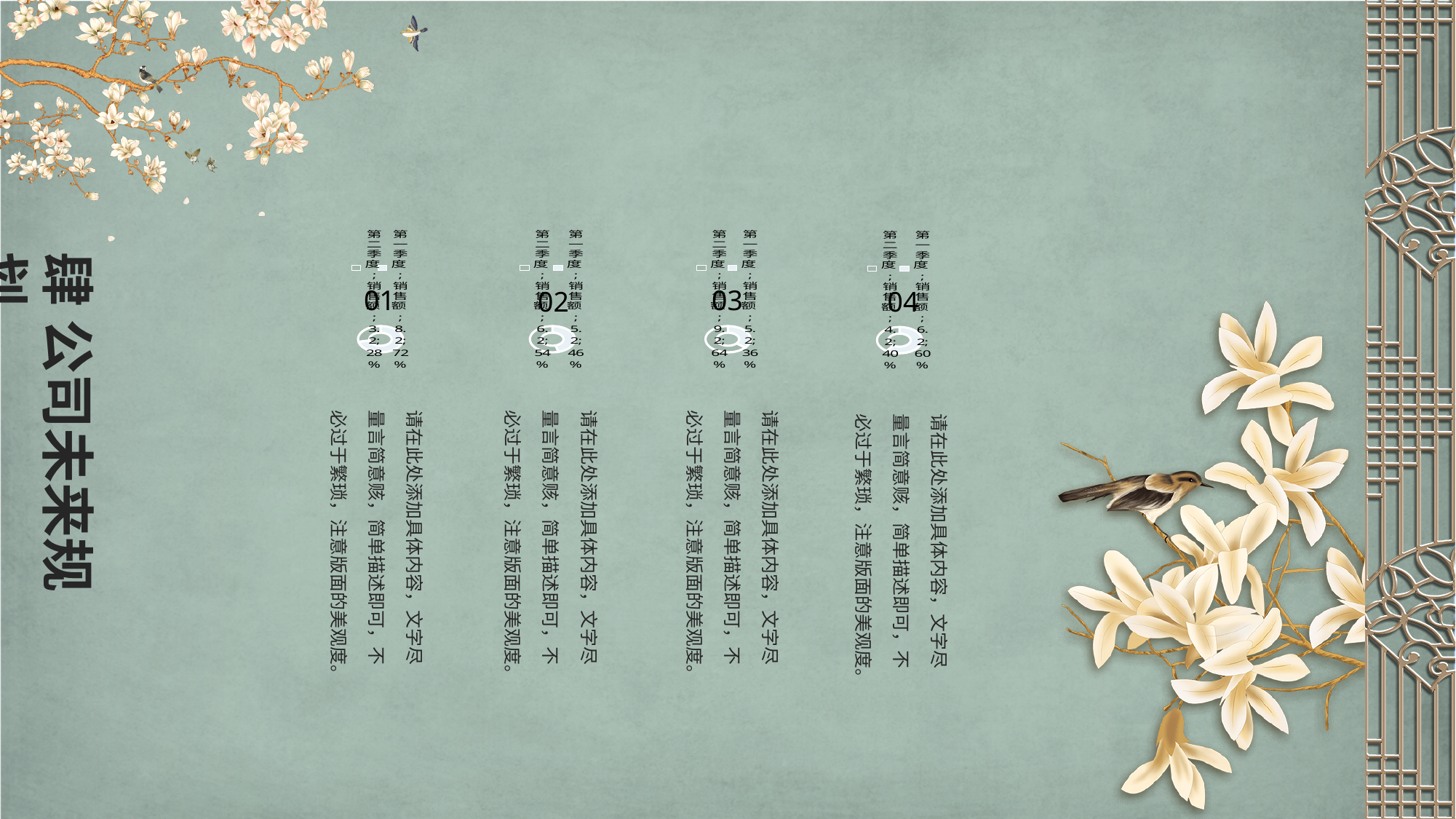
In the chart labelled 03, what is the 销售额 value shown for 第二季度? 9.2 In the chart labelled 01, what is the share shown for 第一季度? 72% What kind of chart is used for the four small charts labelled 01 to 04? Doughnut chart In the chart labelled 02, what is the 销售额 value shown for 第二季度? 6.2 In the chart labelled 01, what is the difference between the 销售额 values for 第一季度 and 第二季度? 5.0 In the chart labelled 03, which quarter has the larger 销售额 value? 第二季度 In the chart labelled 04, which quarter has the larger share, 第一季度 or 第二季度? 第一季度 In the chart labelled 04, what is the share shown for 第一季度? 60% In the chart labelled 02, what is the share shown for 第一季度? 46% How many categories does each of the four small charts show? 2